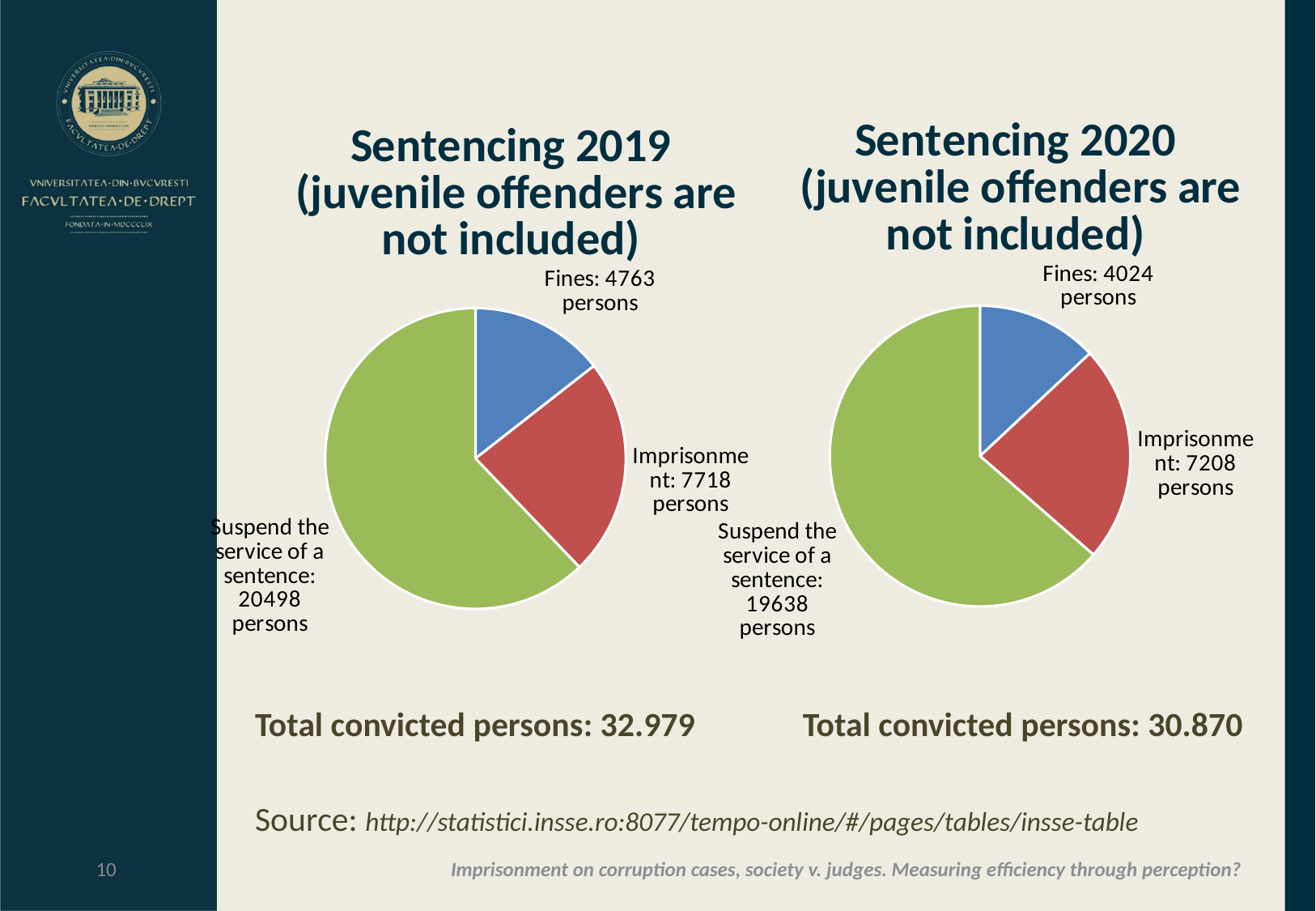
What type of chart is used for Sentencing 2020? pie chart In the Sentencing 2019 chart, which category has the largest slice? Suspend the service of a sentence What is the total number of convicted persons shown for the Sentencing 2019 chart? 32.979 In the Sentencing 2019 chart, what colour is the slice for suspended sentences? green In the Sentencing 2019 chart, what is the difference between the number of persons with a suspended sentence and the number imprisoned? 12780 persons In the Sentencing 2019 chart, how many persons received fines? 4763 persons How many categories does the Sentencing 2019 pie chart show? 3 What is the difference between the number of persons fined in 2019 and in 2020? 739 persons In the Sentencing 2020 chart, which category has the smallest slice? Fines In the Sentencing 2020 chart, is the imprisonment slice larger or smaller than the fines slice? larger In the Sentencing 2020 chart, how many persons had the service of a sentence suspended? 19638 persons In the Sentencing 2020 chart, how many persons were sentenced to imprisonment? 7208 persons